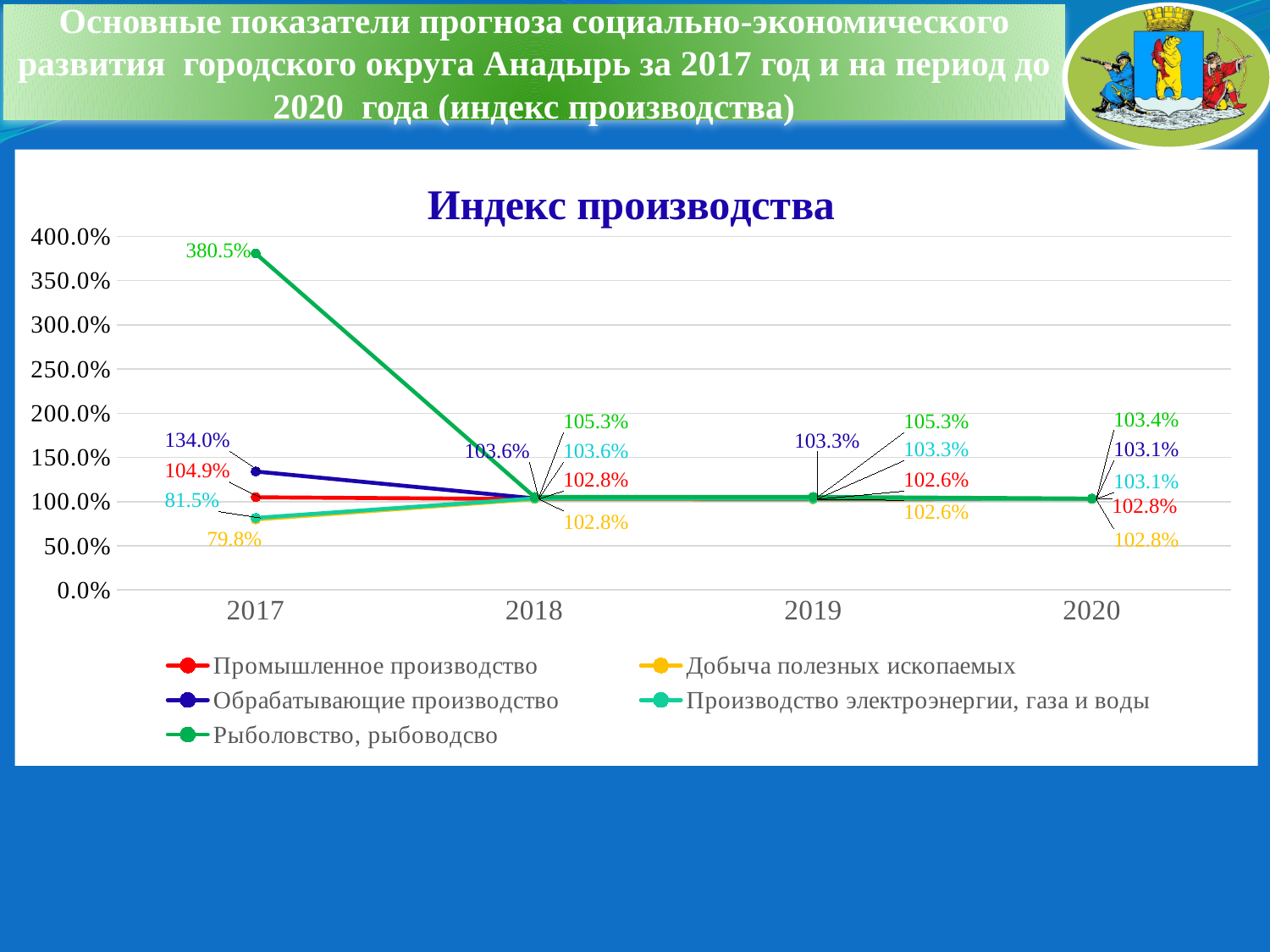
What is the value for Добыча полезных ископаемых in 2017? 79.8% Which series has the highest value in 2017? Рыболовство, рыбоводсво What type of chart is shown on the slide? line chart What is the title of the chart? Индекс производства What is the value for Обрабатывающие производство in 2017? 134.0% Which series has the lowest value in 2017? Добыча полезных ископаемых Does the value for Рыболовство, рыбоводсво rise or fall from 2017 to 2018? fall What is the value for Промышленное производство in 2019? 102.6% How many years are shown on the x axis? 4 What is the difference between the 2017 values for Обрабатывающие производство and Промышленное производство? 29.1% How many series does the legend list? 5 What is the value for Рыболовство, рыбоводсво in 2017? 380.5%